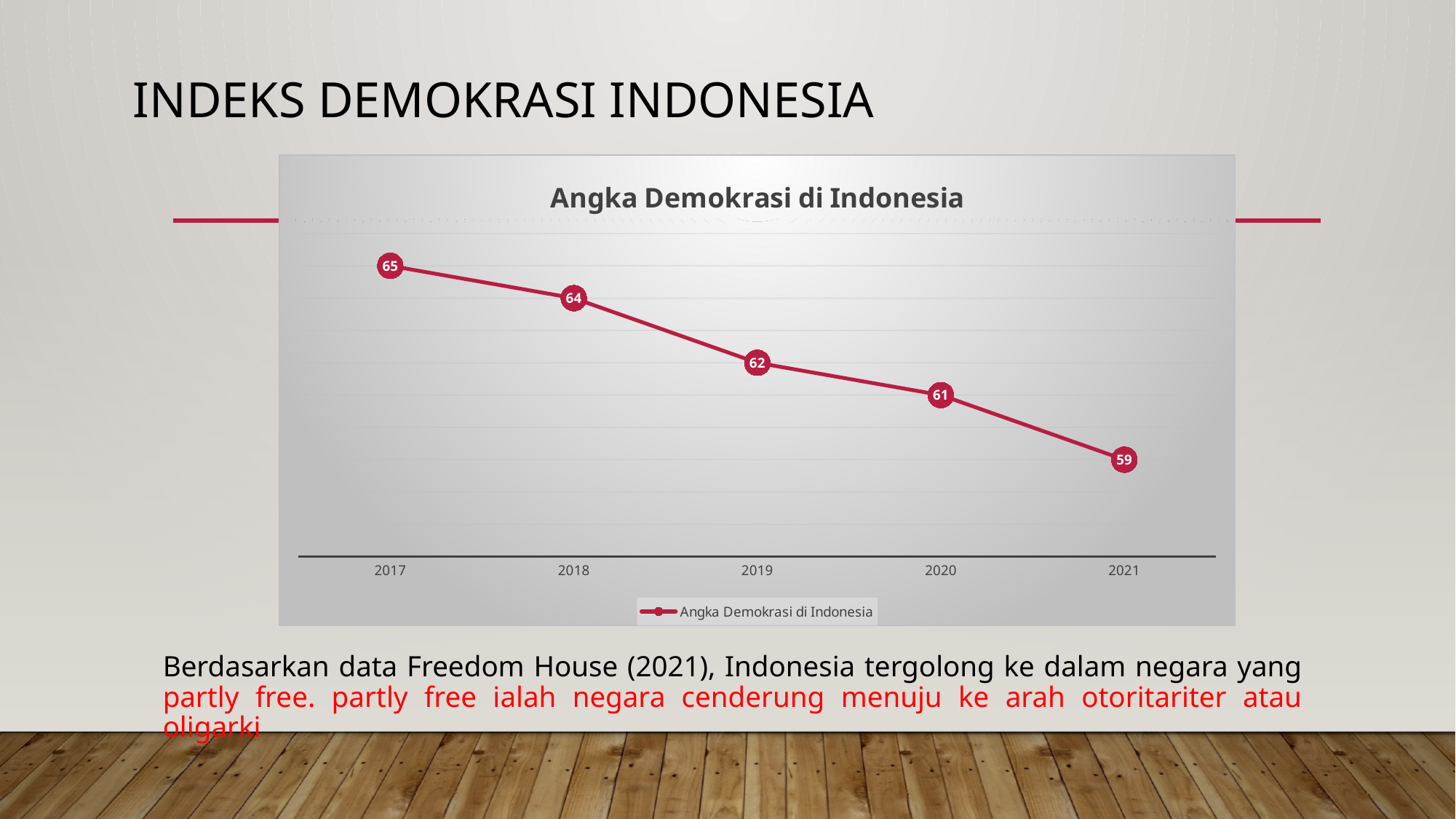
What is the difference between the values for 2017 and 2021? 6 Which year has the lowest value? 2021 What kind of chart is shown? line chart What is the value for 2017? 65 How many series does the legend list? 1 What is the value for 2019? 62 Do the values rise or fall from 2017 to 2021? fall How many years are plotted on the chart? 5 What is the difference between the values for 2018 and 2020? 3 Which is larger, the value for 2018 or the value for 2020? 2018 What is the value for 2021? 59 Which year has the highest value? 2017